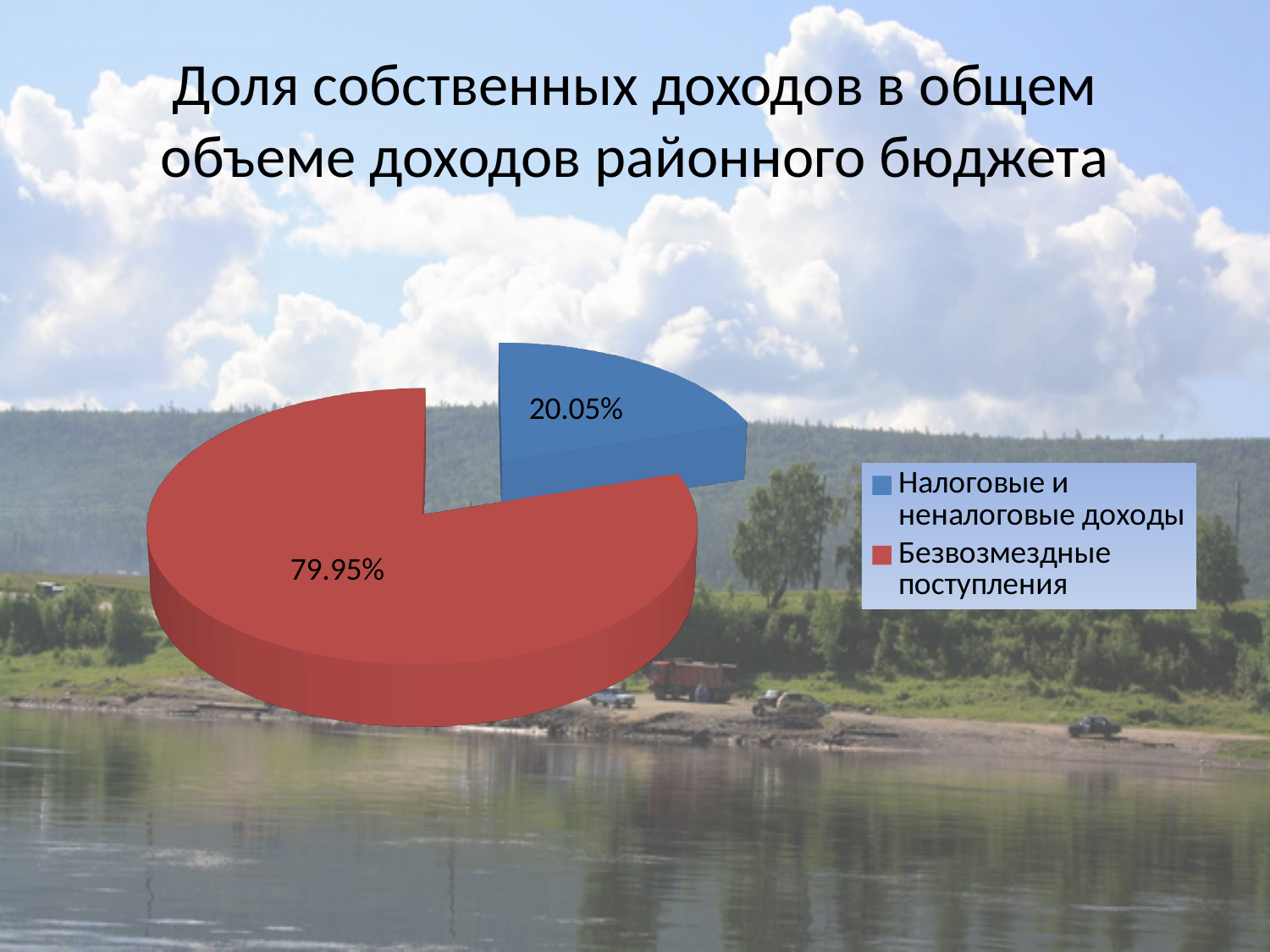
How many slices does the pie chart have? 2 What colour is the slice for Безвозмездные поступления? Red Which is larger: Налоговые и неналоговые доходы or Безвозмездные поступления? Безвозмездные поступления What is the title of the slide? Доля собственных доходов в общем объеме доходов районного бюджета How many entries does the legend list? 2 Which category has the smallest share of the pie? Налоговые и неналоговые доходы Which category has the largest share of the pie? Безвозмездные поступления What is the value for Налоговые и неналоговые доходы? 20.05% What is the value for Безвозмездные поступления? 79.95% What kind of chart is shown on the slide? Pie chart What is the difference between the shares of Безвозмездные поступления and Налоговые и неналоговые доходы? 59.90%